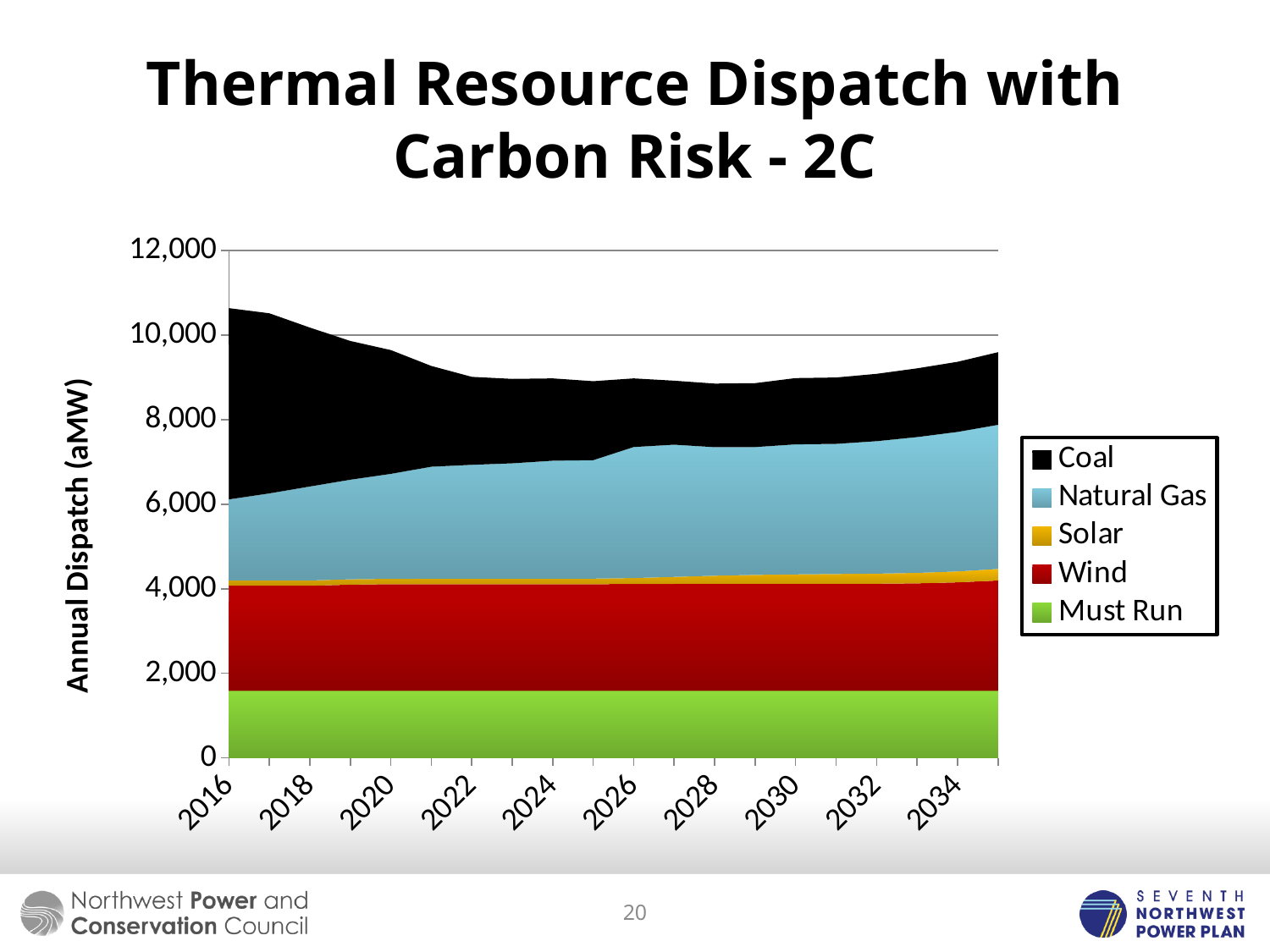
Is the Must Run dispatch in 2016 greater or less than 2,000? less Does the Coal band get thicker or thinner from 2016 to 2034? thinner Which series has the smallest dispatch across the chart? Solar How many series does the legend list? 5 What is the title of the chart on the slide? Thermal Resource Dispatch with Carbon Risk - 2C How many year labels are shown on the x axis? 10 Does the total dispatch rise or fall from 2016 to 2022? fall Is the total dispatch in 2016 greater or less than 10,000? greater Is the total dispatch in 2024 greater or less than 10,000? less What is the label of the vertical axis? Annual Dispatch (aMW) What kind of chart is shown on the slide? Stacked area chart